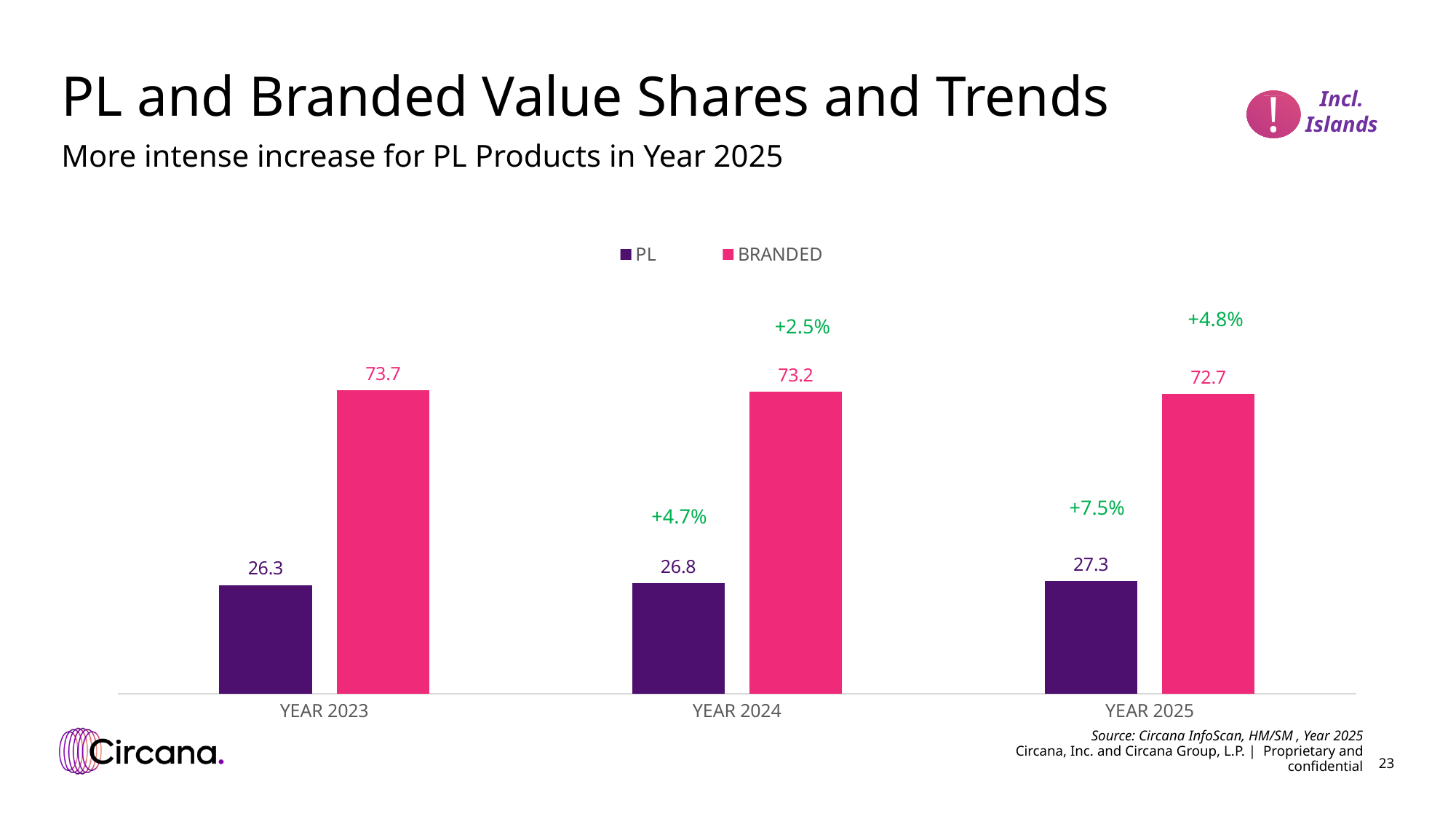
What is the PL value share for YEAR 2023? 26.3 In which year is the BRANDED value share lowest? YEAR 2025 Which is larger in YEAR 2023, the PL share or the BRANDED share? BRANDED How many series does the legend list? 2 What is the BRANDED value share for YEAR 2025? 72.7 What is the BRANDED value share for YEAR 2024? 73.2 Does the PL value share rise or fall from YEAR 2023 to YEAR 2025? Rise What kind of chart is shown on the slide? Bar chart In which year is the PL value share highest? YEAR 2025 What growth percentage is shown above the PL bar for YEAR 2025? +7.5% How many years are shown on the x axis? 3 What is the difference between the BRANDED and PL value shares in YEAR 2024? 46.4